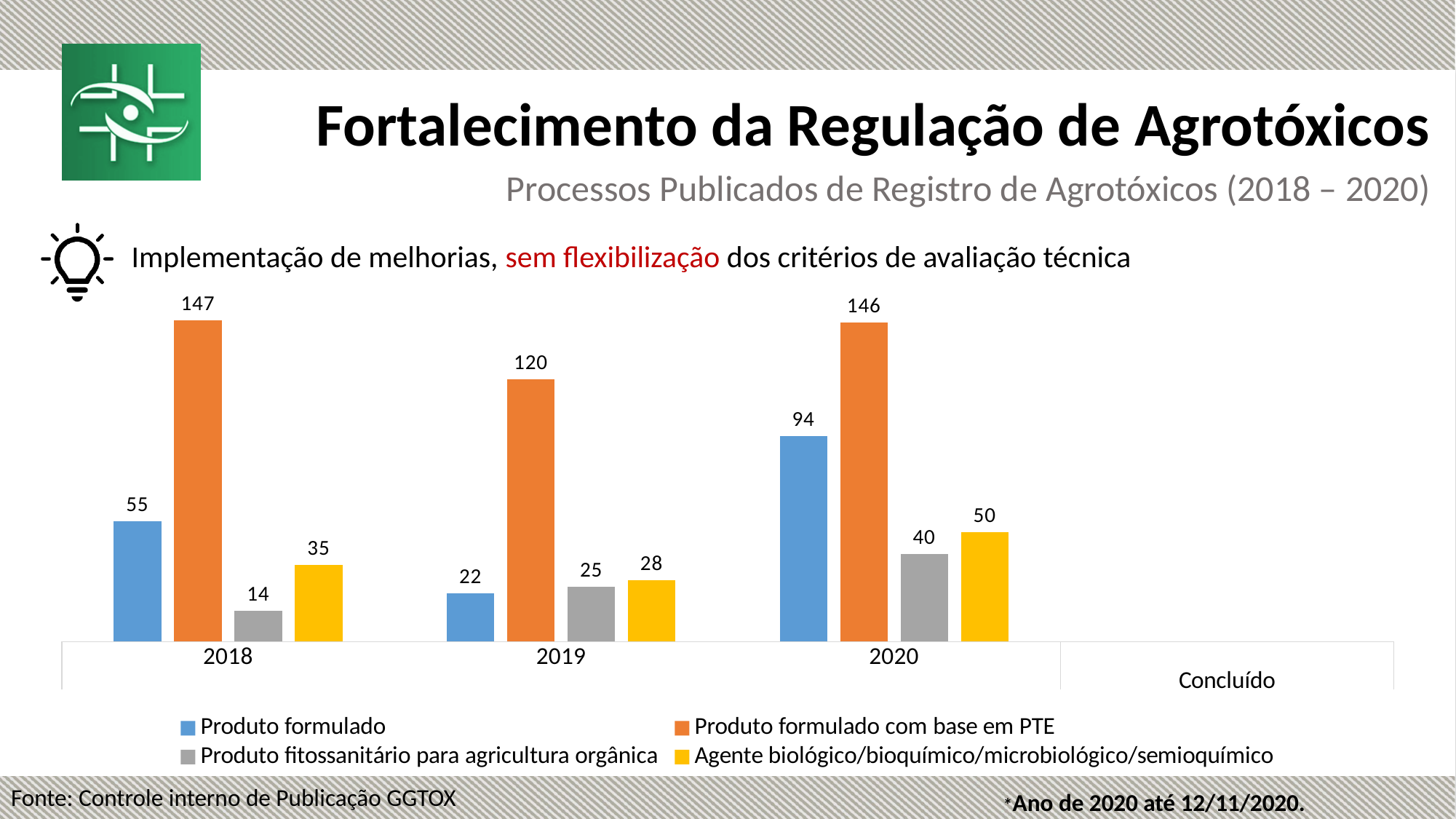
Which year has the highest value for Produto formulado? 2020 Which is larger: Produto formulado in 2020 or Produto formulado in 2018? Produto formulado in 2020 How many years are shown on the x axis? 3 What is the value for Agente biológico/bioquímico/microbiológico/semioquímico in 2020? 50 Which colour represents Produto formulado com base em PTE in the legend? Orange What is the difference between the Produto formulado com base em PTE values for 2018 and 2019? 27 Which year has the lowest value for Produto fitossanitário para agricultura orgânica? 2018 What is the value for Produto formulado com base em PTE in 2019? 120 What kind of chart is shown on the slide? Bar chart What is the value for Produto formulado in 2018? 55 What is the value for Produto fitossanitário para agricultura orgânica in 2018? 14 How many series does the legend list? 4